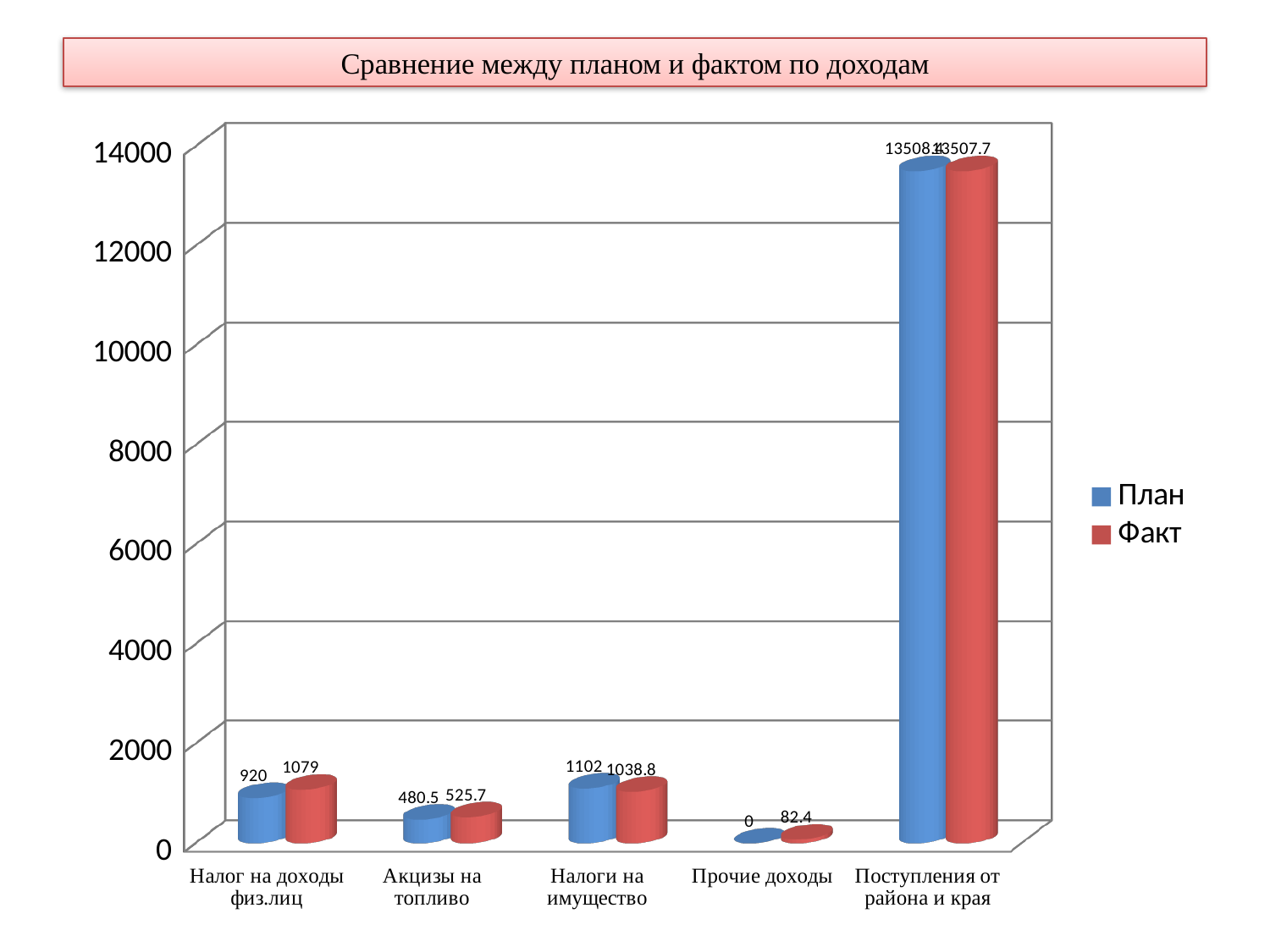
By how much does the Факт value exceed the План value for Налог на доходы физ.лиц? 159 What is the Факт value for Прочие доходы? 82.4 What is the Факт value for Налог на доходы физ.лиц? 1079 How many series does the legend list? 2 How many categories are shown on the x axis? 5 Which category has the highest Факт value? Поступления от района и края Which category has the lowest План value? Прочие доходы What is the План value for Акцизы на топливо? 480.5 What is the План value for Прочие доходы? 0 What is the Факт value for Налоги на имущество? 1038.8 What is the difference between the Факт and План values for Акцизы на топливо? 45.2 For Налоги на имущество, which is larger: План or Факт? План